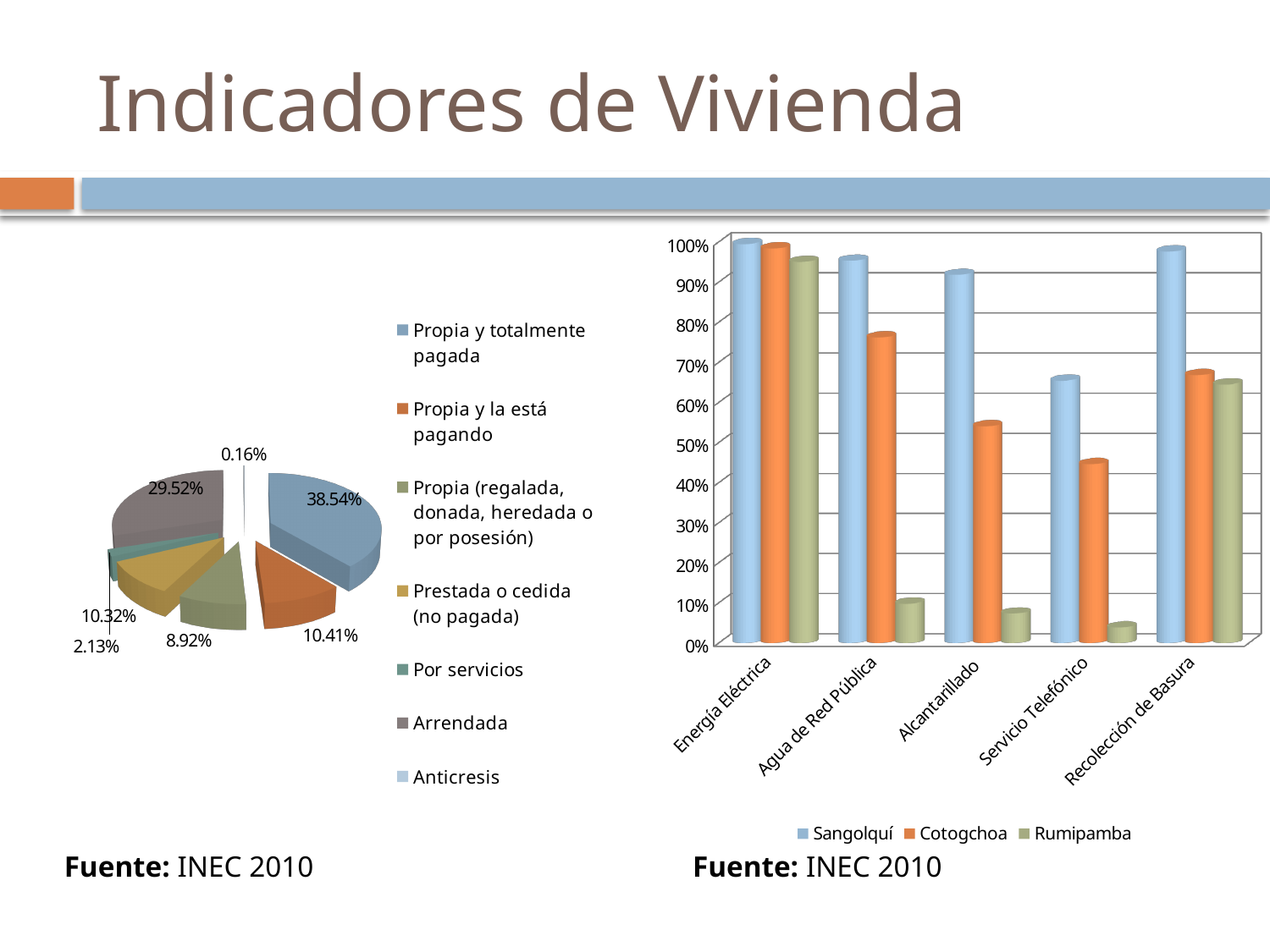
In the pie chart on the left, which category has the largest share? Propia y totalmente pagada In the pie chart on the left, which category has the smallest share? Anticresis In the pie chart on the left, what share is labelled for the 'Propia y totalmente pagada' slice? 38.54% In the pie chart on the left, what share is labelled for the 'Arrendada' slice? 29.52% In the pie chart on the left, what is the difference between the 'Propia y totalmente pagada' share and the 'Arrendada' share? 9.02% What kind of chart is the chart on the right of the slide? Bar chart In the bar chart on the right, which series has the lowest value for 'Servicio Telefónico'? Rumipamba How many series does the legend of the bar chart on the right list? 3 In the bar chart on the right, which is larger for 'Recolección de Basura': Sangolquí or Cotogchoa? Sangolquí In the bar chart on the right, is the value for Cotogchoa in 'Alcantarillado' greater or less than 50%? greater In the bar chart on the right, is the value for Rumipamba in 'Agua de Red Pública' greater or less than 20%? less How many categories does the legend of the pie chart on the left list? 7